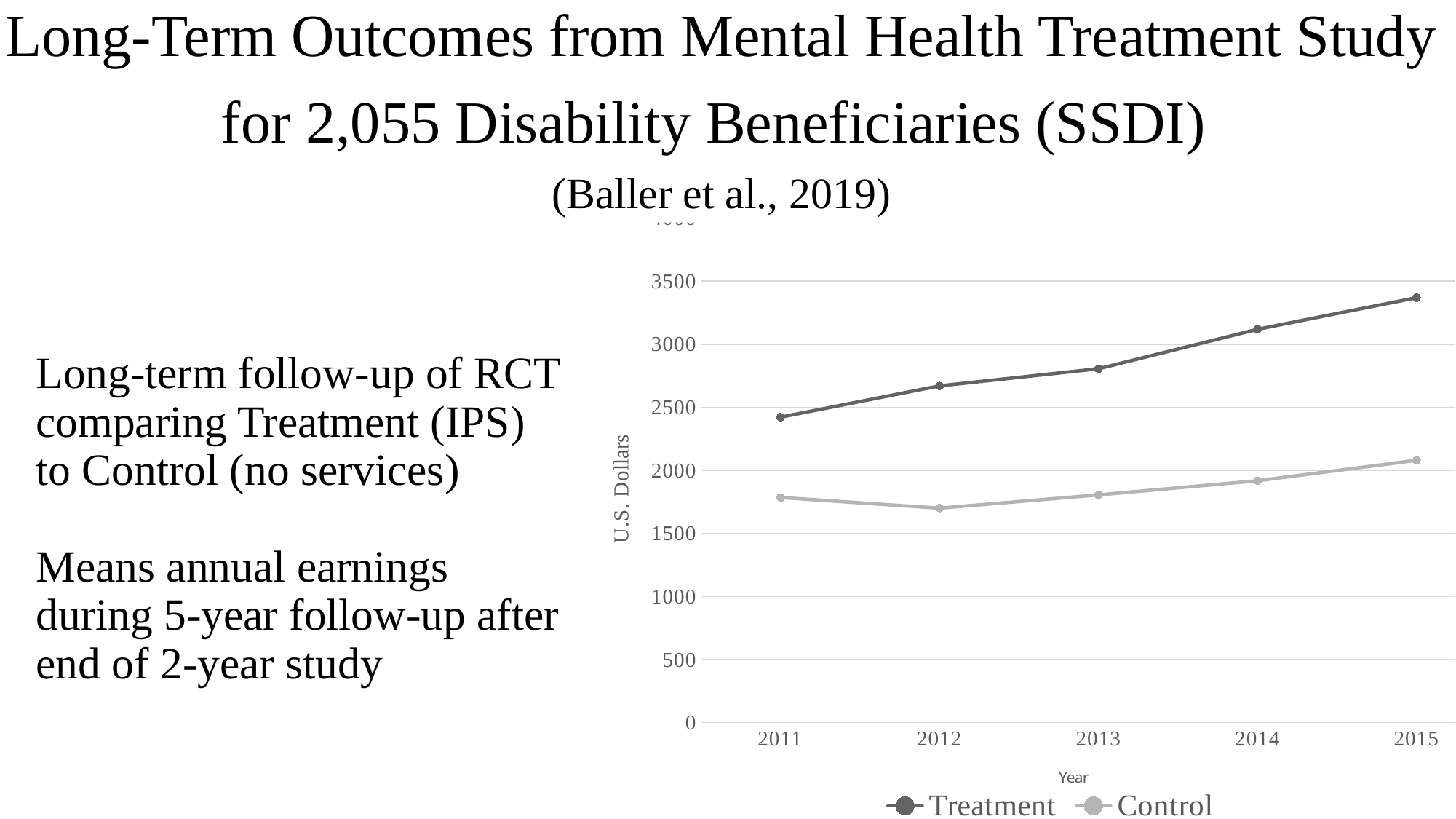
Is the Treatment value for 2011 greater or less than 2500? less Is the Treatment value for 2015 greater or less than 3000? greater How many years are plotted along the x axis of the chart? 5 In which year is the Control series at its lowest? 2012 What kind of chart is shown on the slide? line chart Is the Control value for 2012 greater or less than 2000? less What is the label on the y axis of the chart? U.S. Dollars Does the Treatment series rise or fall from 2011 to 2015? rise In 2013, which series has the larger value, Treatment or Control? Treatment How many series does the chart legend list? 2 In which year is the Treatment series at its highest? 2015